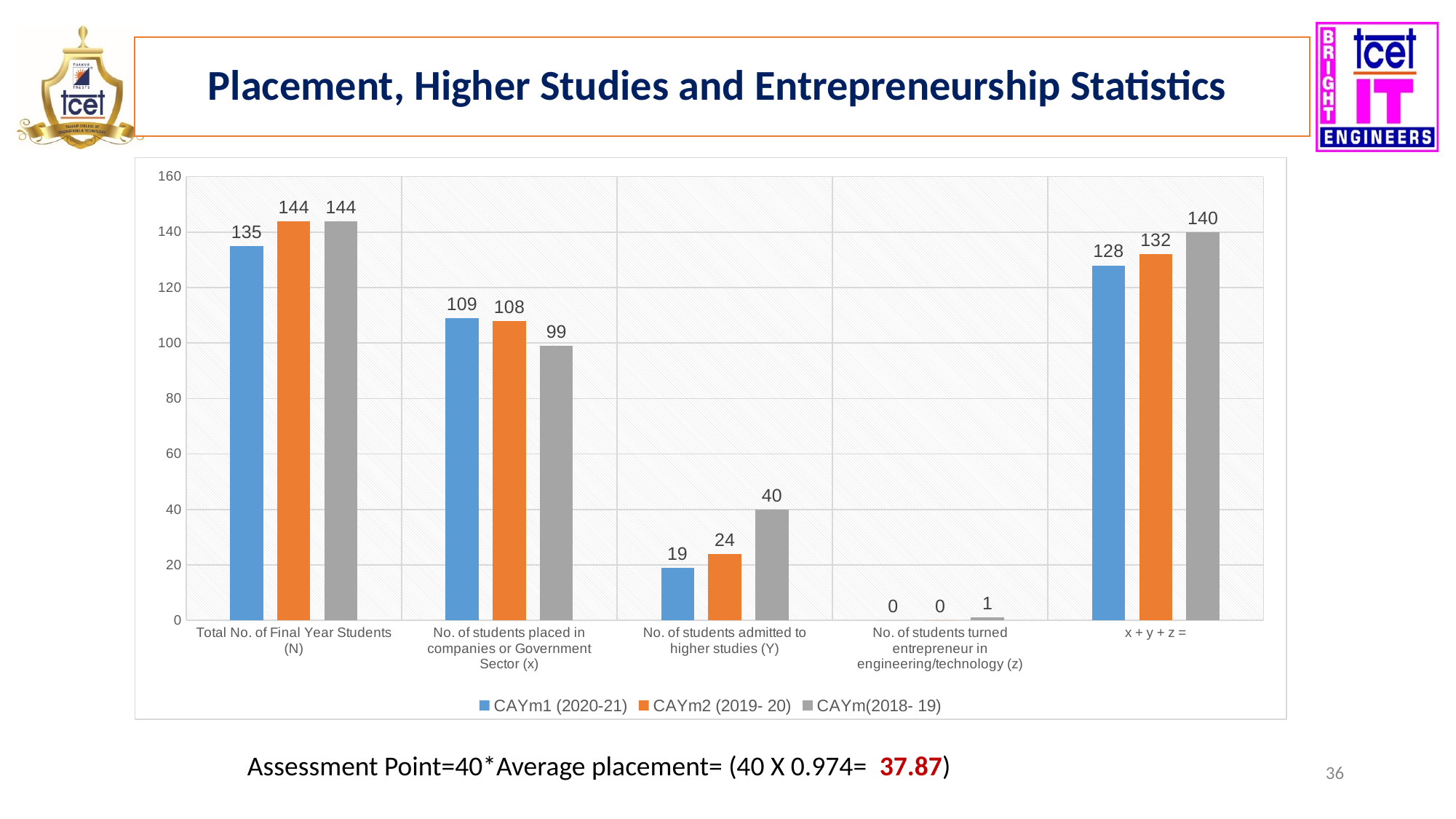
What is the value for CAYm(2018- 19) in the 'No. of students placed in companies or Government Sector (x)' category? 99 What kind of chart is shown on the slide? bar chart What is the value for CAYm(2018- 19) in the 'No. of students turned entrepreneur in engineering/technology (z)' category? 1 What is the value for CAYm1 (2020-21) in the 'Total No. of Final Year Students (N)' category? 135 What is the value for CAYm2 (2019- 20) in the 'No. of students admitted to higher studies (Y)' category? 24 Which is larger for 'Total No. of Final Year Students (N)': CAYm1 (2020-21) or CAYm2 (2019- 20)? CAYm2 (2019- 20) Which series has the lowest value in the 'No. of students admitted to higher studies (Y)' category? CAYm1 (2020-21) How many categories are shown on the x axis of the chart? 5 How many series does the legend list? 3 What is the difference between the CAYm1 (2020-21) and CAYm(2018- 19) values for 'No. of students placed in companies or Government Sector (x)'? 10 Which colour represents the CAYm2 (2019- 20) series in the chart? orange Which series has the highest value in the 'x + y + z =' category? CAYm(2018- 19)